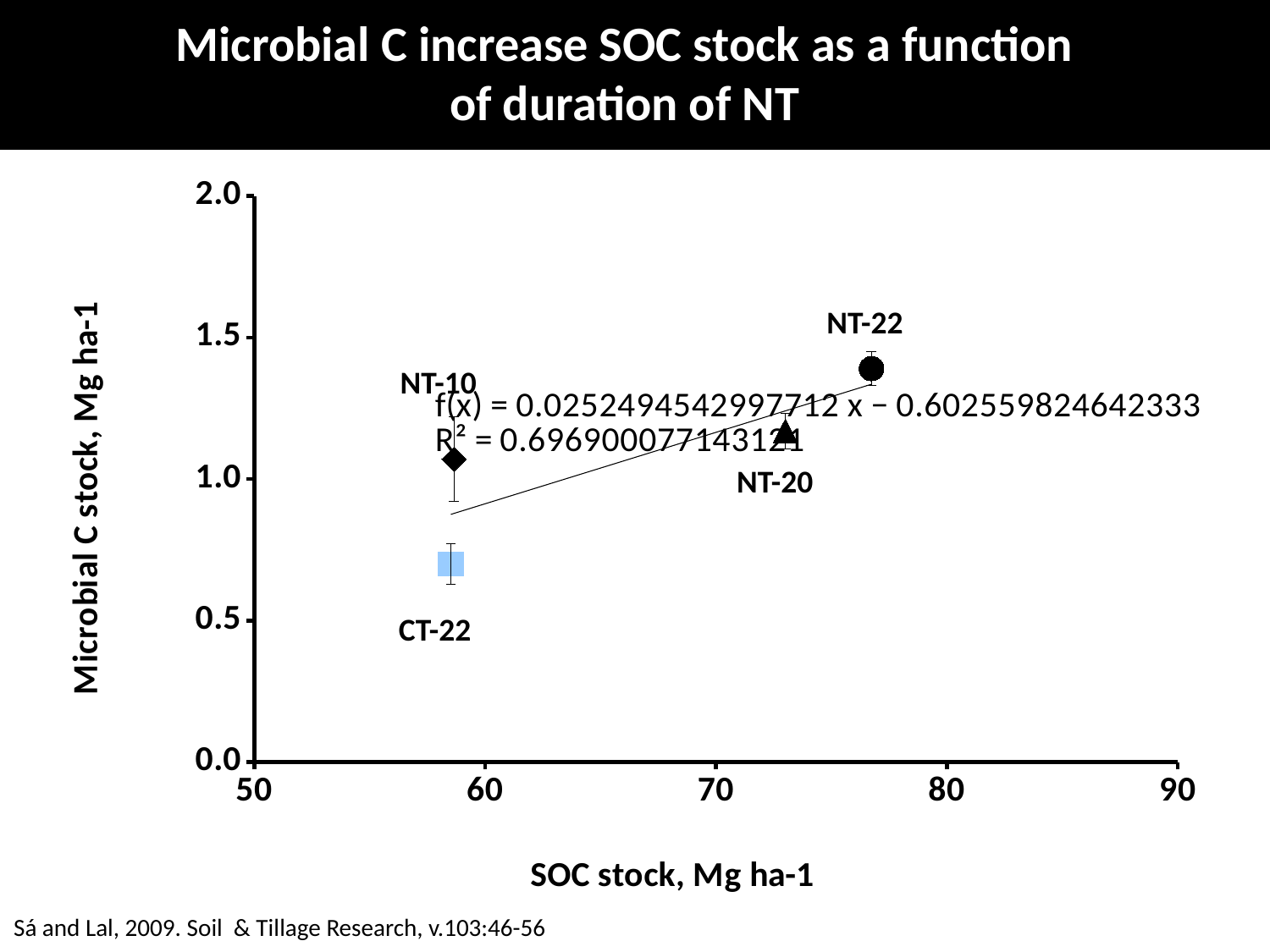
Which labelled point has the highest microbial C stock? NT-22 Is the microbial C stock for NT-20 greater or less than 1.0 Mg ha-1? greater How many labelled data points are plotted on the chart? 4 Is the microbial C stock for CT-22 greater or less than 1.0 Mg ha-1? less Is the SOC stock for NT-22 greater or less than 70 Mg ha-1? greater What kind of chart is shown on the slide? Scatter chart What R² value is printed on the chart for the fitted line? 0.696900077143121 Which labelled point has the lowest microbial C stock? CT-22 Which has the larger microbial C stock, NT-22 or NT-20? NT-22 What is the label of the x axis? SOC stock, Mg ha-1 Does the fitted trend line show microbial C stock rising or falling as SOC stock increases? Rising Which has the larger microbial C stock, NT-10 or CT-22? NT-10